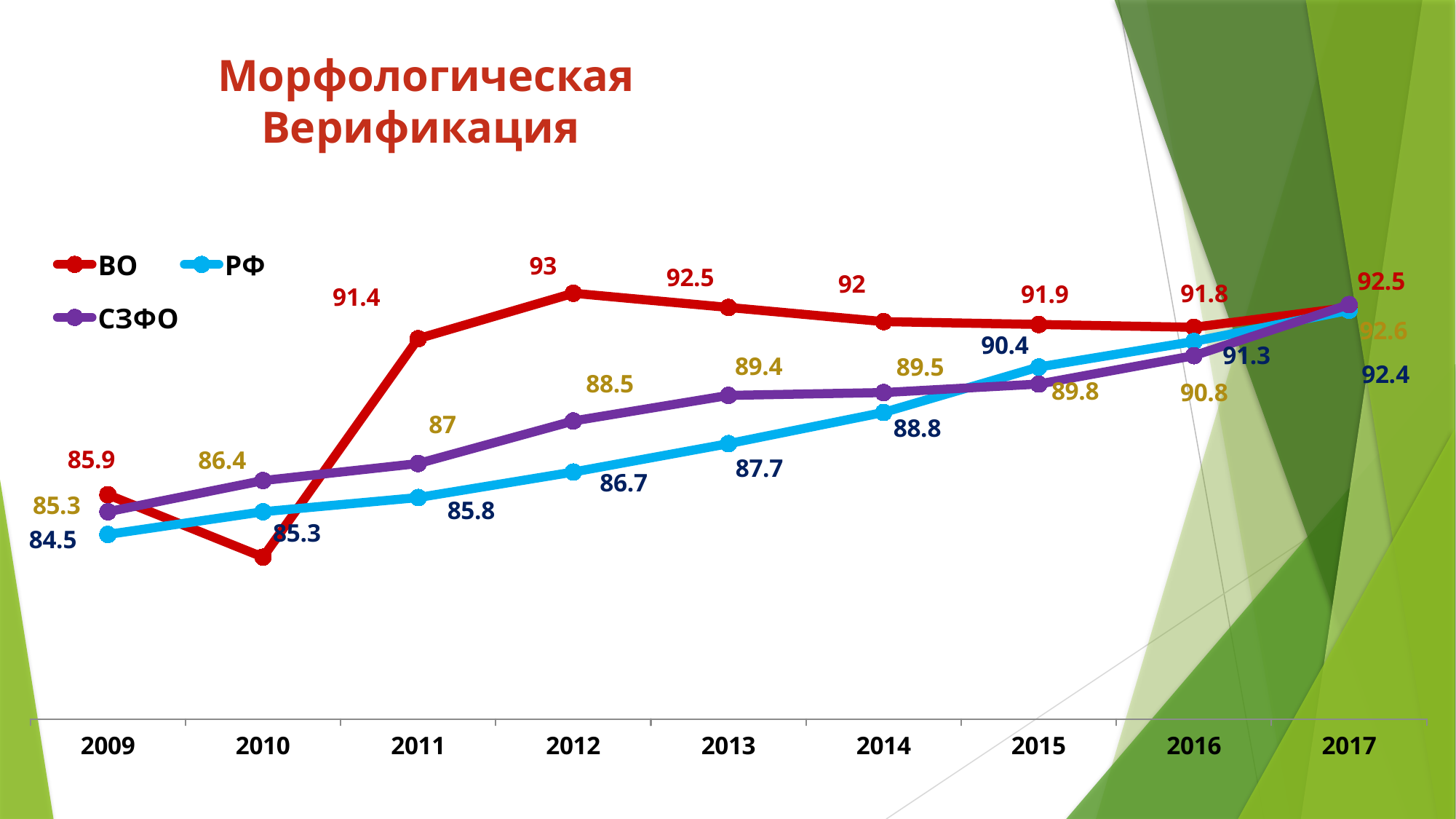
What is the value for ВО in 2012? 93 What is the value for СЗФО in 2011? 87 In 2013, which series has the larger value, ВО or СЗФО? ВО Does the РФ series rise or fall from 2009 to 2017? Rises What is the difference between the РФ value in 2017 and in 2009? 7.9 How many series does the legend list? 3 What is the value for СЗФО in 2016? 90.8 What is the value for РФ in 2009? 84.5 In which year does the ВО series reach its highest value? 2012 In which year is the РФ series at its lowest value? 2009 How many years are shown on the x axis? 9 What kind of chart is shown on the slide? Line chart